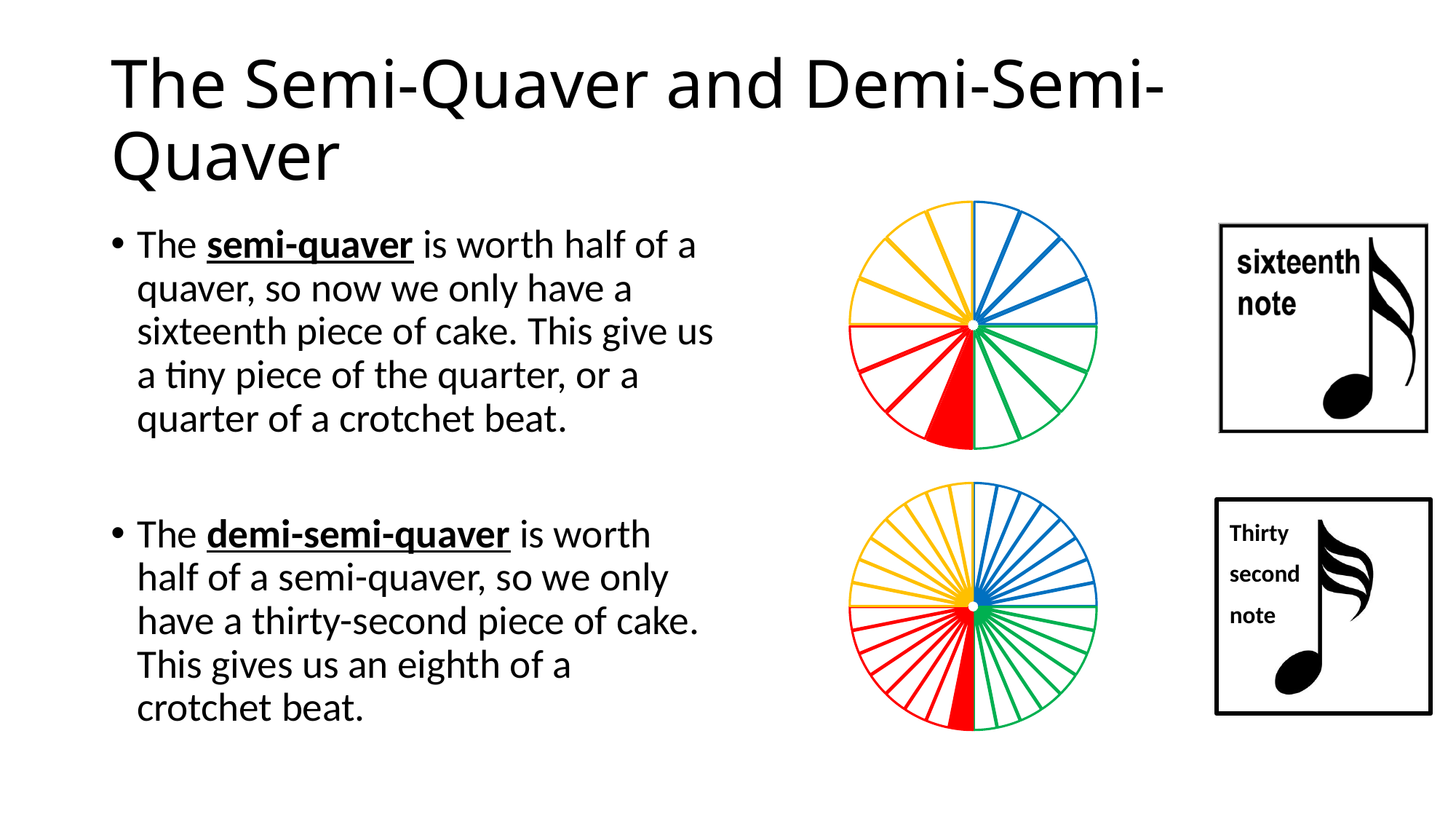
In the bottom pie chart, how many slices is the circle divided into? 32 How many different colours are used for the slice outlines in the bottom pie chart? 4 How many more slices does the bottom pie chart have than the top pie chart? 16 In the top pie chart, how many slices is the circle divided into? 16 In the top pie chart, what colour is the single filled slice? red In the bottom pie chart, what fraction of the whole circle does the filled red slice represent? one thirty-second In the bottom pie chart, how many slices are filled in solid colour? 1 What kind of chart is the bottom chart on the slide? pie chart In the top pie chart, what fraction of the whole circle does the filled red slice represent? one sixteenth What kind of chart is the top chart on the slide? pie chart Which chart has more slices, the top pie chart or the bottom pie chart? the bottom pie chart